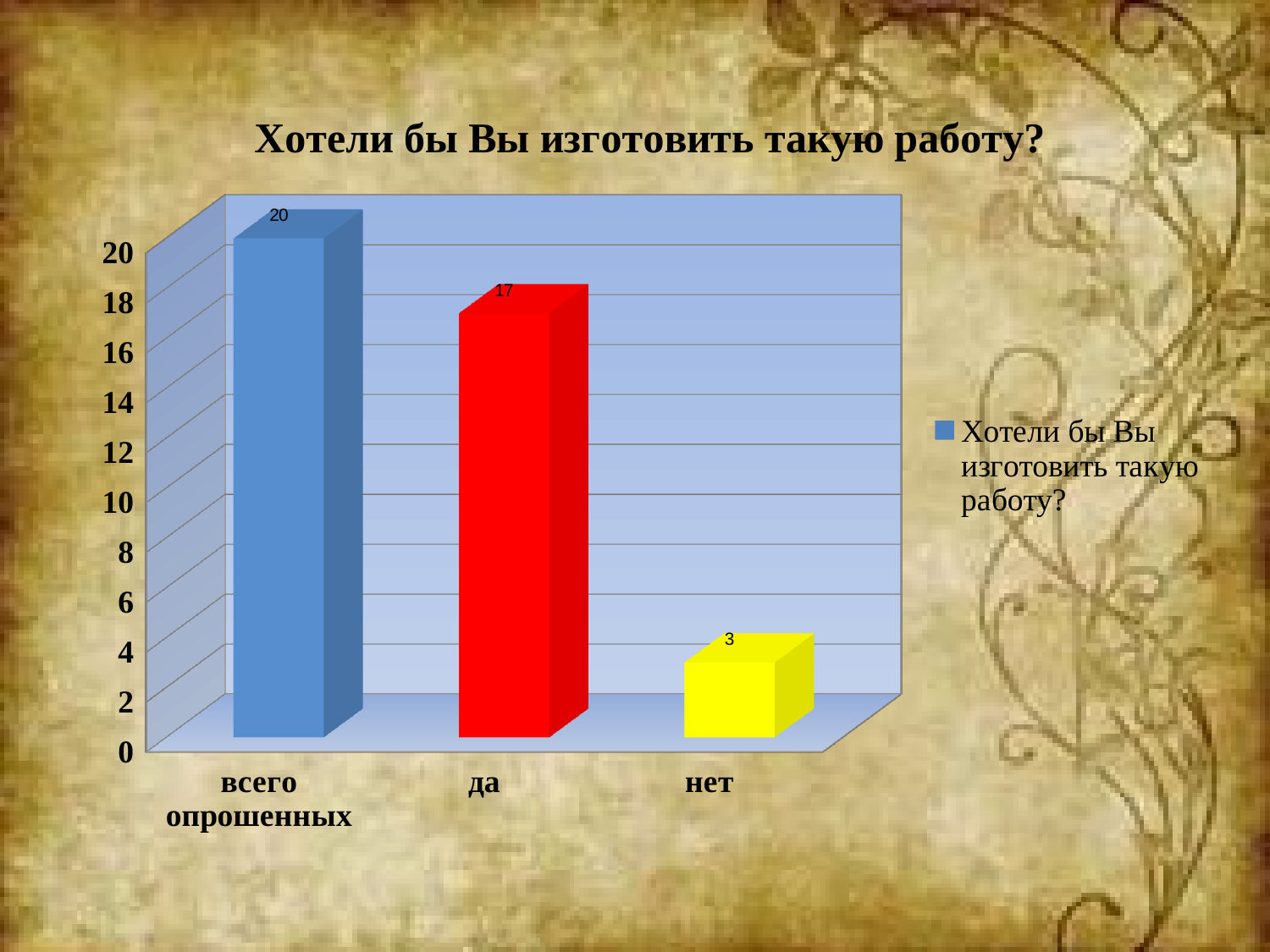
What is the difference between the values for "всего опрошенных" and "да"? 3 What is the value for "да"? 17 Which is larger, the value for "да" or the value for "нет"? да What is the title of the chart? Хотели бы Вы изготовить такую работу? What is the value for "всего опрошенных"? 20 What is the difference between the values for "да" and "нет"? 14 Which category has the lowest value? нет Which category has the highest value? всего опрошенных Is the value for "да" greater or less than 10? greater How many categories are shown on the x axis? 3 What is the value for "нет"? 3 What kind of chart is shown on the slide? bar chart